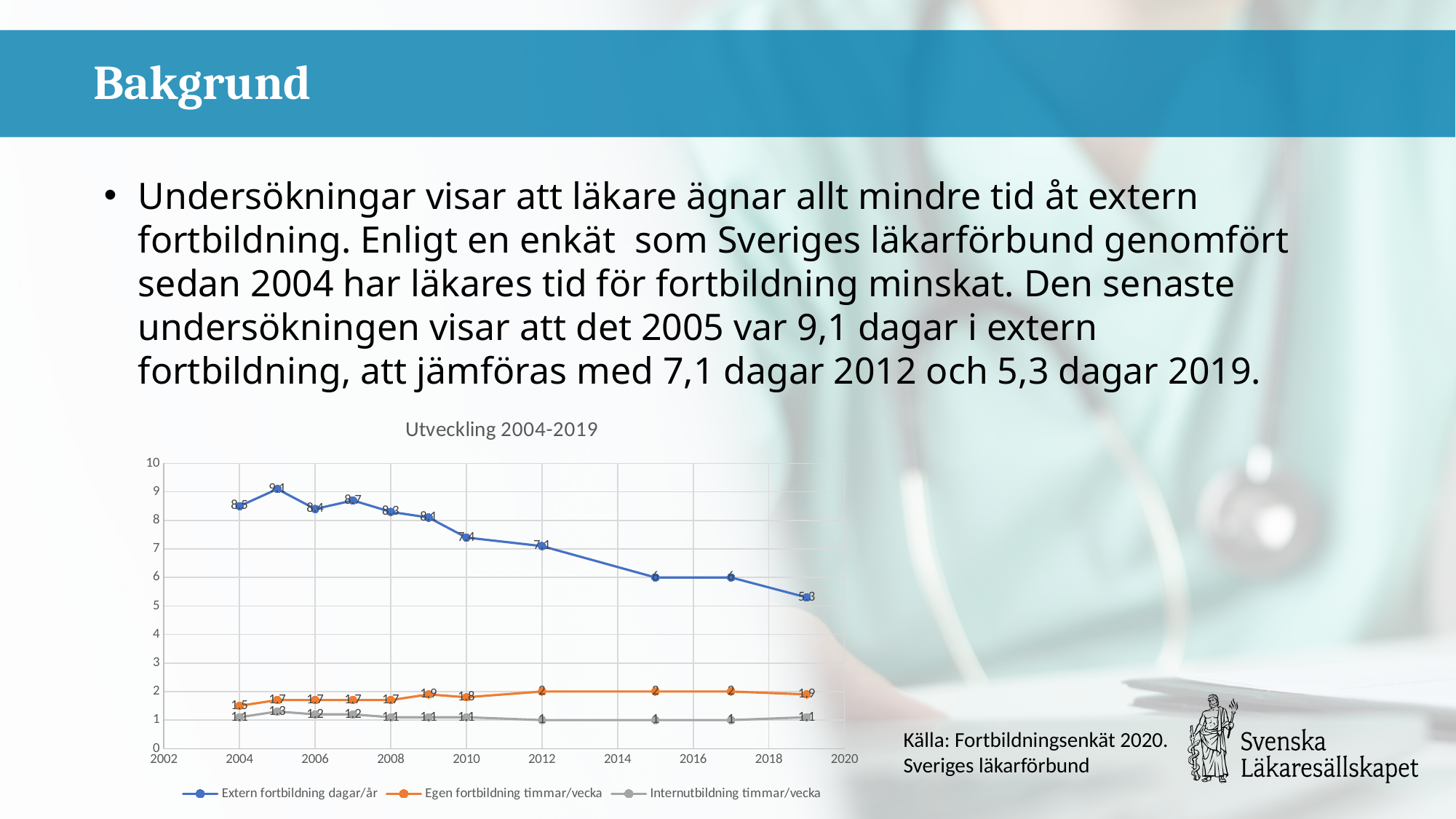
What is the highest value of the Extern fortbildning dagar/år series? 9,1 What is the difference between the Extern fortbildning dagar/år values in 2005 and 2019? 3,8 Does the Extern fortbildning dagar/år series generally rise or fall from 2005 to 2019? fall What is the value of Extern fortbildning dagar/år in 2012? 7,1 What is the title of the chart? Utveckling 2004-2019 In which year does the Extern fortbildning dagar/år series reach its highest value? 2005 What kind of chart is shown on the slide? line chart How many series does the legend of the chart list? 3 In which year is the Extern fortbildning dagar/år series lowest? 2019 What is the value of Egen fortbildning timmar/vecka in 2012? 2 What is the value of Extern fortbildning dagar/år in 2015? 6 Which series has the higher value in 2019, Egen fortbildning timmar/vecka or Internutbildning timmar/vecka? Egen fortbildning timmar/vecka